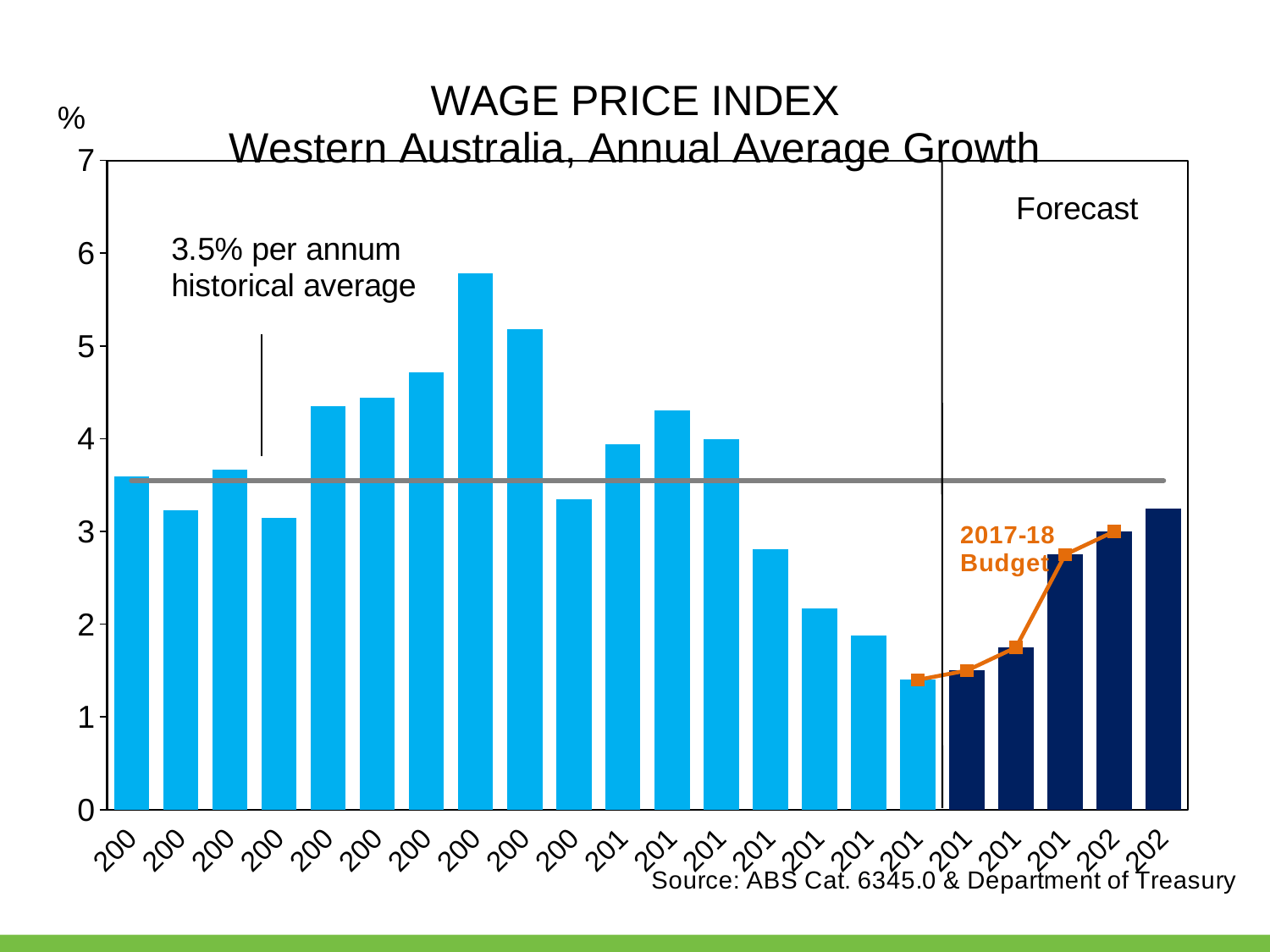
What value does the horizontal grey line in the chart represent? 3.5% per annum historical average What kind of chart is shown on the slide? combination bar and line chart Is the value of the shortest bar greater or less than 2? less What is the title of the chart? WAGE PRICE INDEX Western Australia, Annual Average Growth How many dark blue forecast bars are shown in the chart? 5 How many orange square markers are on the 2017-18 Budget line? 5 Is the value of the rightmost bar greater or less than 3? greater Is the value of the tallest bar greater or less than 5? greater What label is given to the orange line in the chart? 2017-18 Budget Do the bar values rise or fall across the forecast period on the right of the chart? rise How many bars are plotted in the chart? 22 Is the tallest bar in the historical (light blue) section or the forecast (dark blue) section? historical (light blue) section